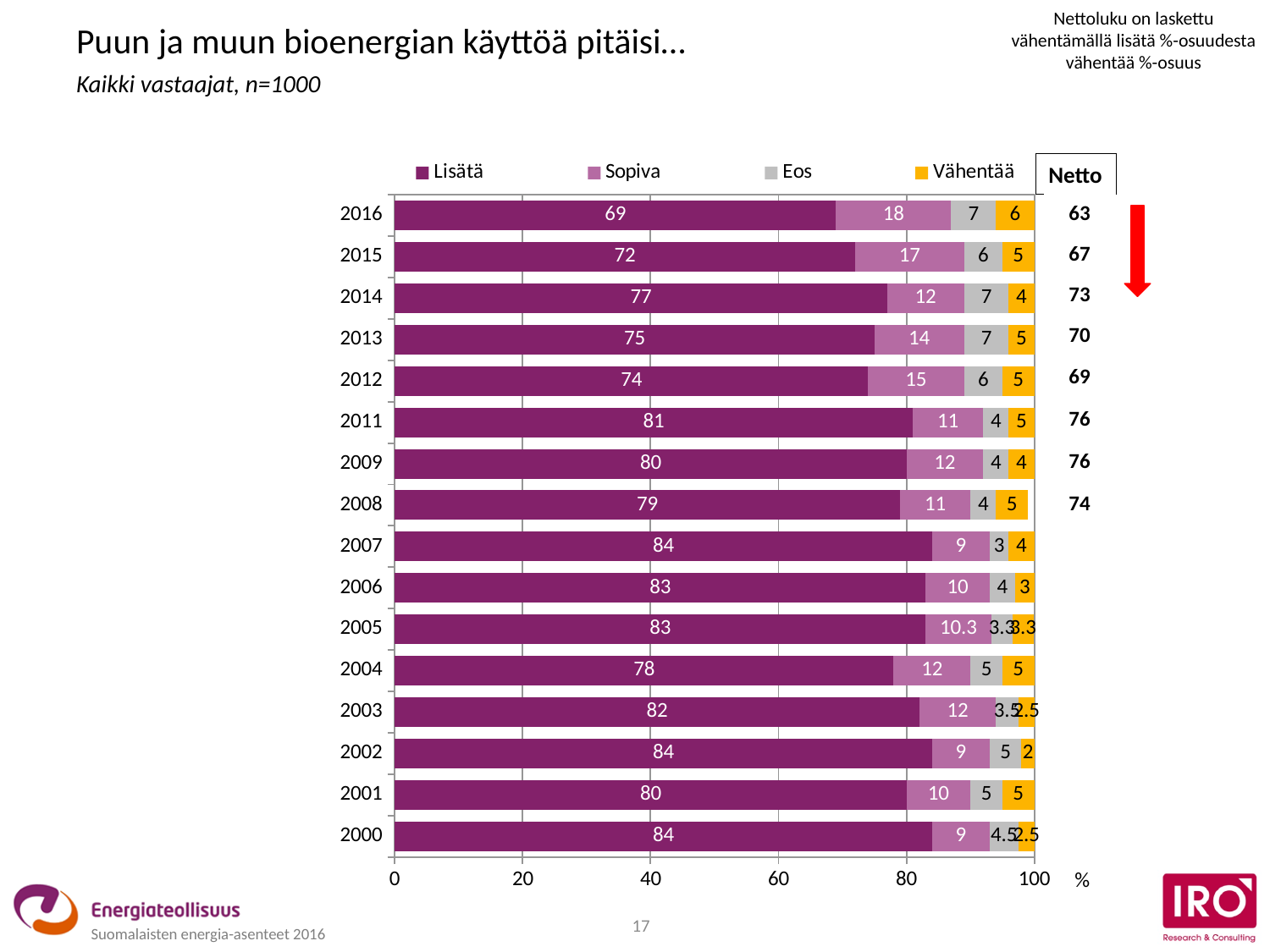
How many series does the legend list? 4 In which year is the "Lisätä" share the lowest? 2016 What is the total of the stacked bar for 2016 (Lisätä + Sopiva + Eos + Vähentää)? 100 In which year is the "Sopiva" share the highest? 2016 What percentage of respondents answered "Lisätä" in 2016? 69 What is the "Sopiva" value for 2015? 17 What is the Netto value shown for 2016? 63 By how many percentage points did the "Lisätä" share fall from 2015 to 2016? 3 What type of chart is shown on the slide? Stacked bar chart Which year has a larger "Lisätä" share, 2011 or 2012? 2011 What is the "Vähentää" value for 2014? 4 How many years (bars) are shown in the chart? 16